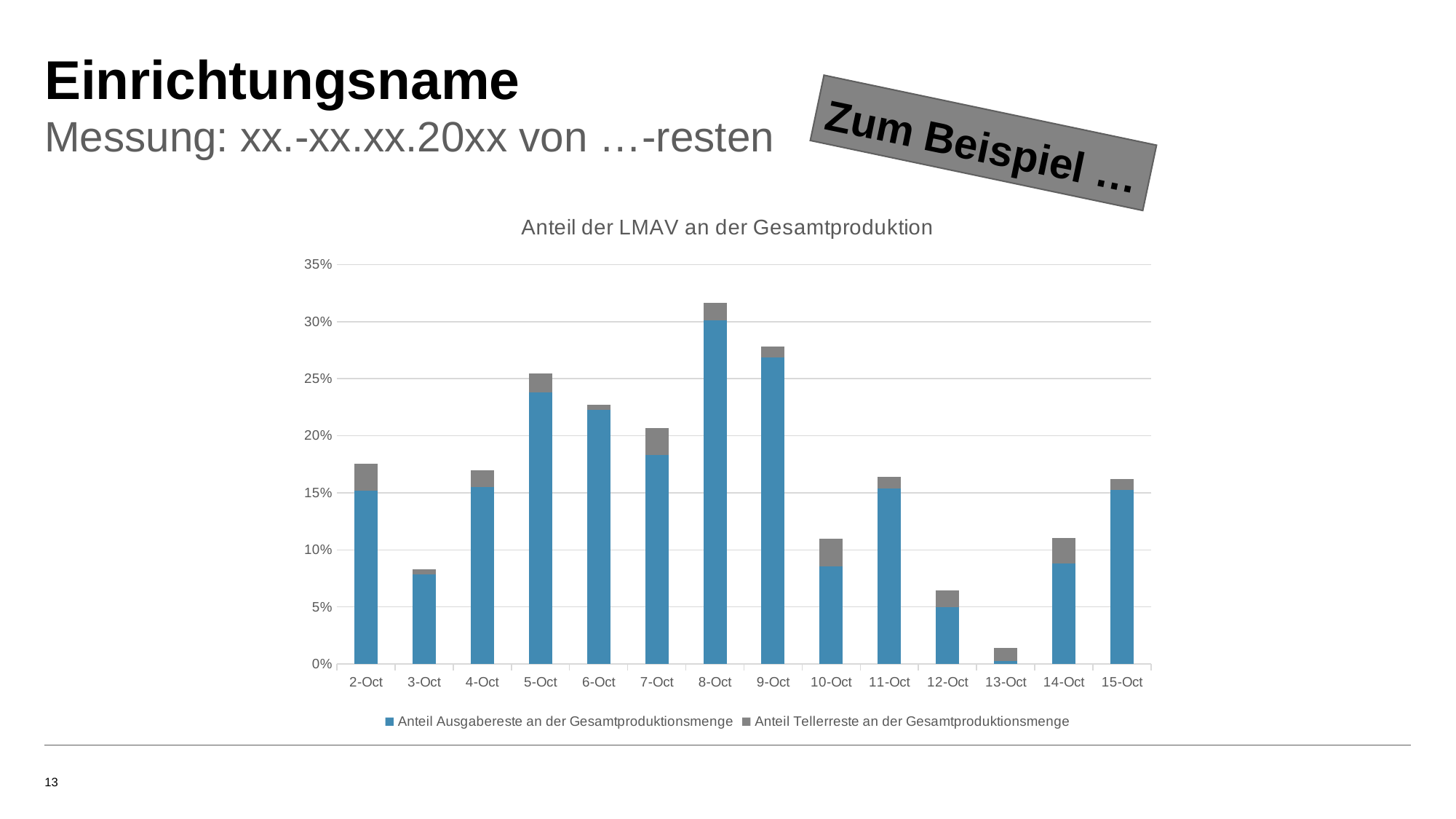
Which has the larger total bar, 5-Oct or 6-Oct? 5-Oct How many series does the chart's legend list? 2 Which date has the lowest total bar in the chart? 13-Oct Which date has the highest total bar in the chart? 8-Oct What is the title of the chart? Anteil der LMAV an der Gesamtproduktion Is the total bar for 8-Oct greater or less than 30%? greater What kind of chart is shown on the slide? Stacked bar chart Is the total bar for 13-Oct greater or less than 5%? less Which has the larger total bar, 3-Oct or 12-Oct? 3-Oct How many dates are shown on the x axis of the chart? 14 Is the total bar for 6-Oct greater or less than 20%? greater